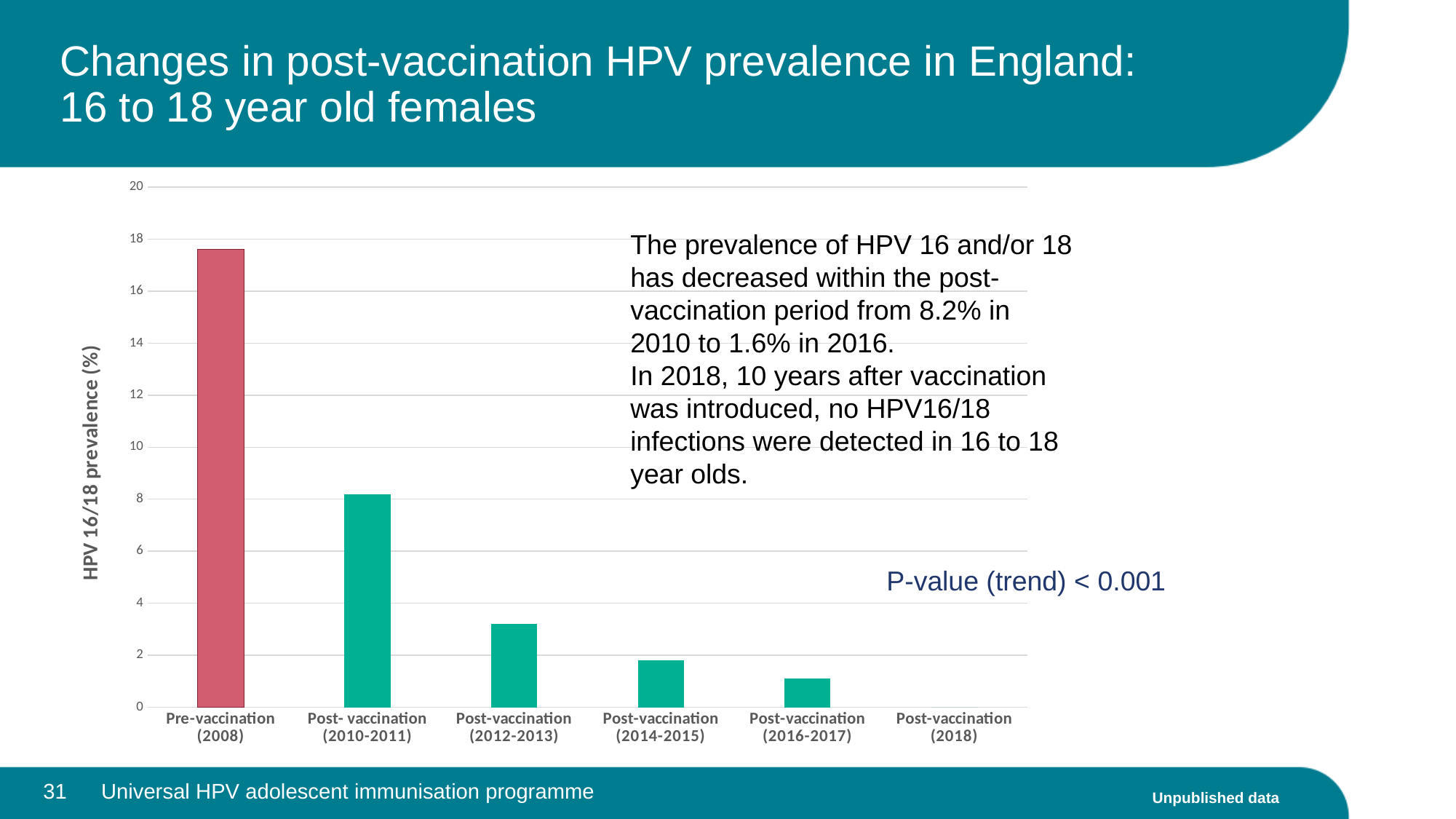
Is the value for Post-vaccination (2016-2017) greater or less than 2? less What is the HPV 16/18 prevalence shown for Post-vaccination (2018)? 0 Is the value for Post-vaccination (2010-2011) greater or less than 10? less Which category has the lowest HPV 16/18 prevalence? Post-vaccination (2018) What kind of chart is shown on the slide? Bar chart What is the label on the y axis of the chart? HPV 16/18 prevalence (%) Which is larger, the value for Pre-vaccination (2008) or Post-vaccination (2010-2011)? Pre-vaccination (2008) Is the value for Pre-vaccination (2008) greater or less than 16? greater How many categories are shown on the x axis of the chart? 6 Which category has the highest HPV 16/18 prevalence? Pre-vaccination (2008) Do the values rise or fall from left to right along the x axis? Fall